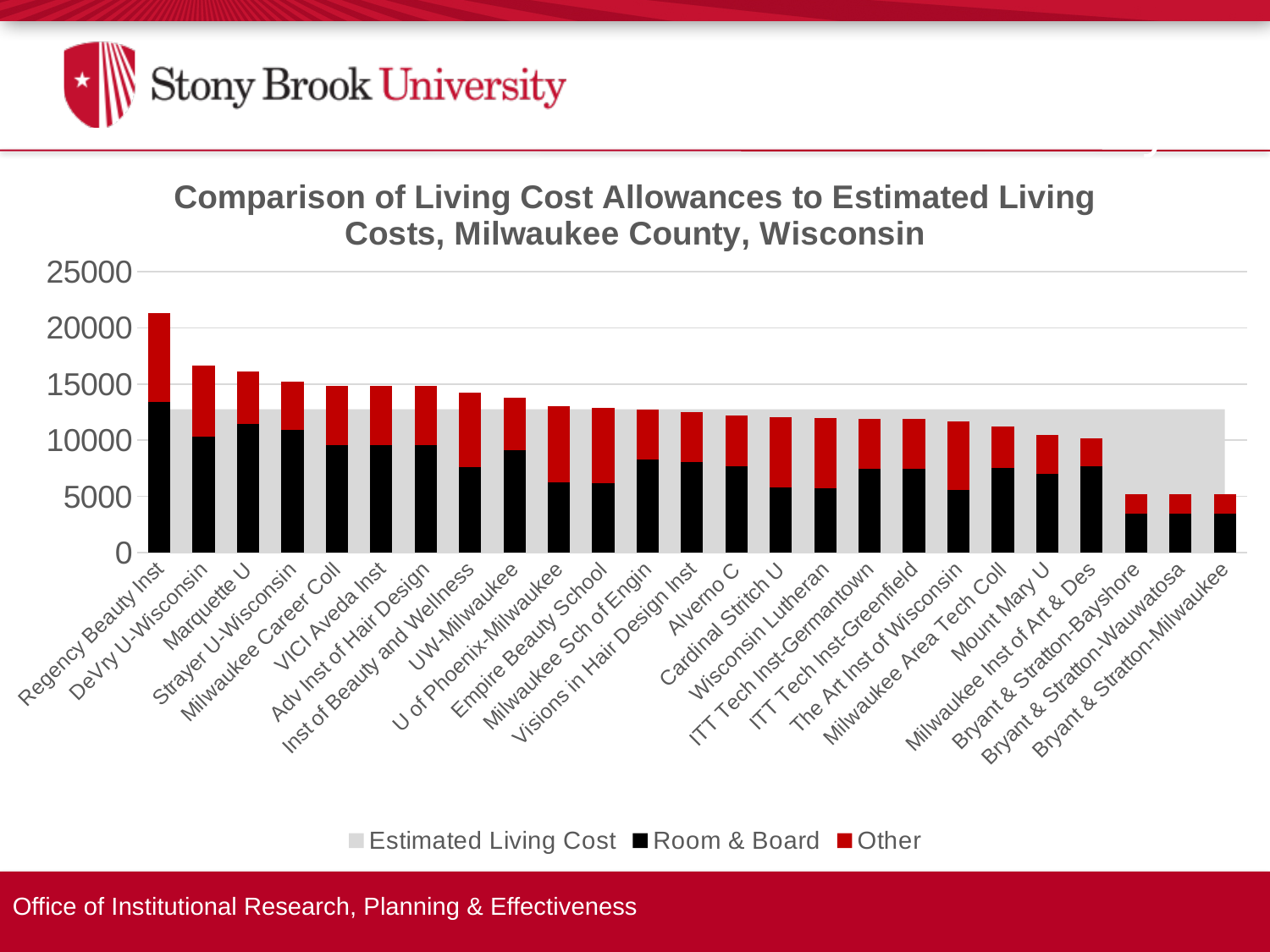
Which has the larger total living cost allowance, Regency Beauty Inst or DeVry U-Wisconsin? Regency Beauty Inst How many institutions are shown along the x axis? 25 Is the total living cost allowance for Regency Beauty Inst greater or less than 20000? greater Is the Room & Board value for Regency Beauty Inst greater or less than 10000? greater What kind of chart is shown on the slide? Stacked bar chart Is the total living cost allowance for Bryant & Stratton-Bayshore greater or less than 10000? less Which institution has the highest total living cost allowance (Room & Board plus Other)? Regency Beauty Inst Do the total living cost allowances generally rise or fall moving from left to right along the x axis? Fall Which series is shown in black in the legend? Room & Board How many series does the legend list? 3